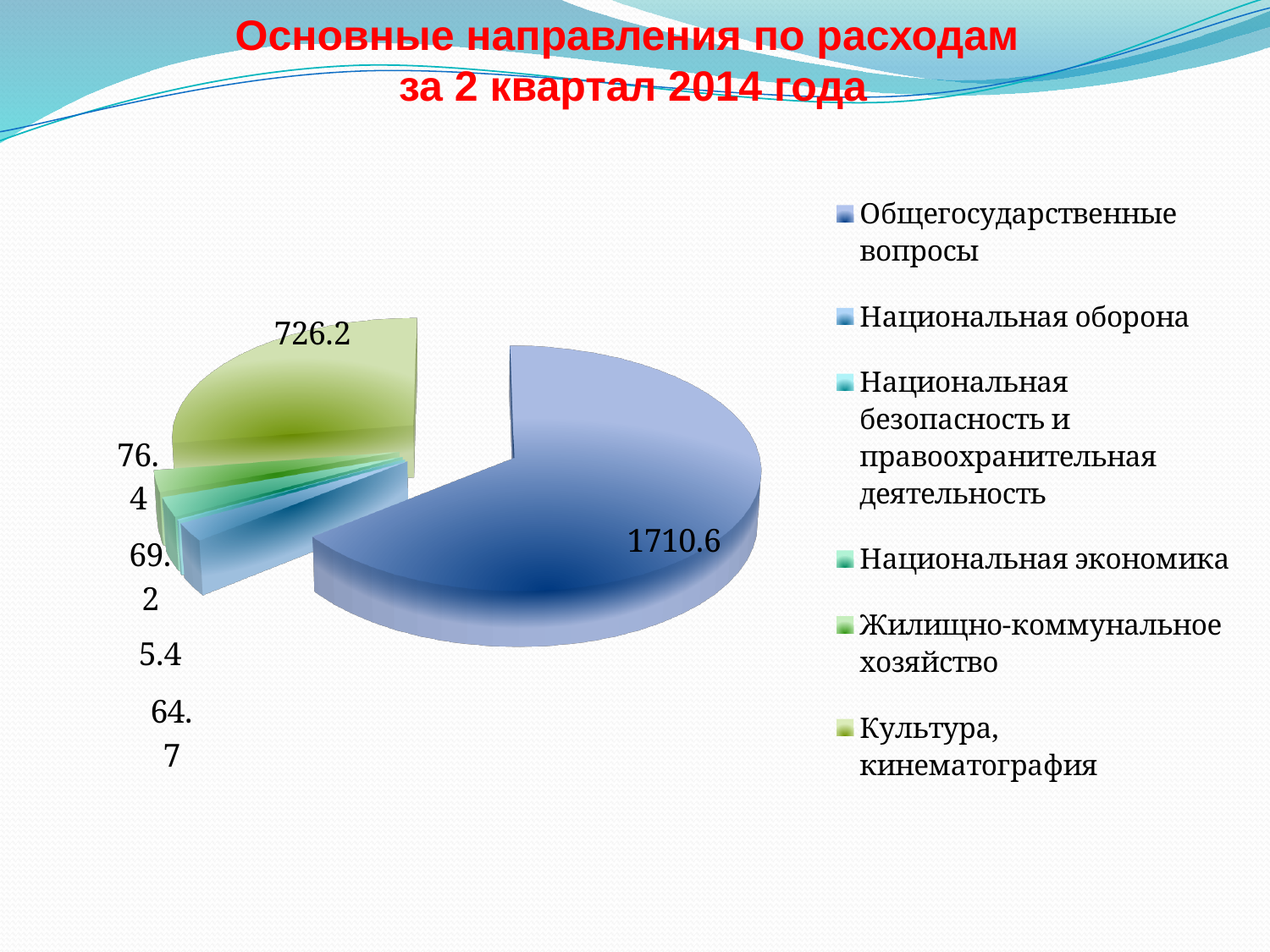
What is the value shown for Культура, кинематография? 726.2 What is the difference between the values for Общегосударственные вопросы and Культура, кинематография? 984.4 What kind of chart is shown on the slide? pie chart How many categories does the legend of the pie chart list? 6 What is the title of the slide containing the pie chart? Основные направления по расходам за 2 квартал 2014 года Which is larger: the value for Общегосударственные вопросы or the value for Культура, кинематография? Общегосударственные вопросы What is the smallest data label shown on the pie chart? 5.4 What is the value shown for Общегосударственные вопросы? 1710.6 Which category is listed last in the legend of the pie chart? Культура, кинематография What is the largest data label shown on the pie chart? 1710.6 Which category has the largest slice in the pie chart? Общегосударственные вопросы